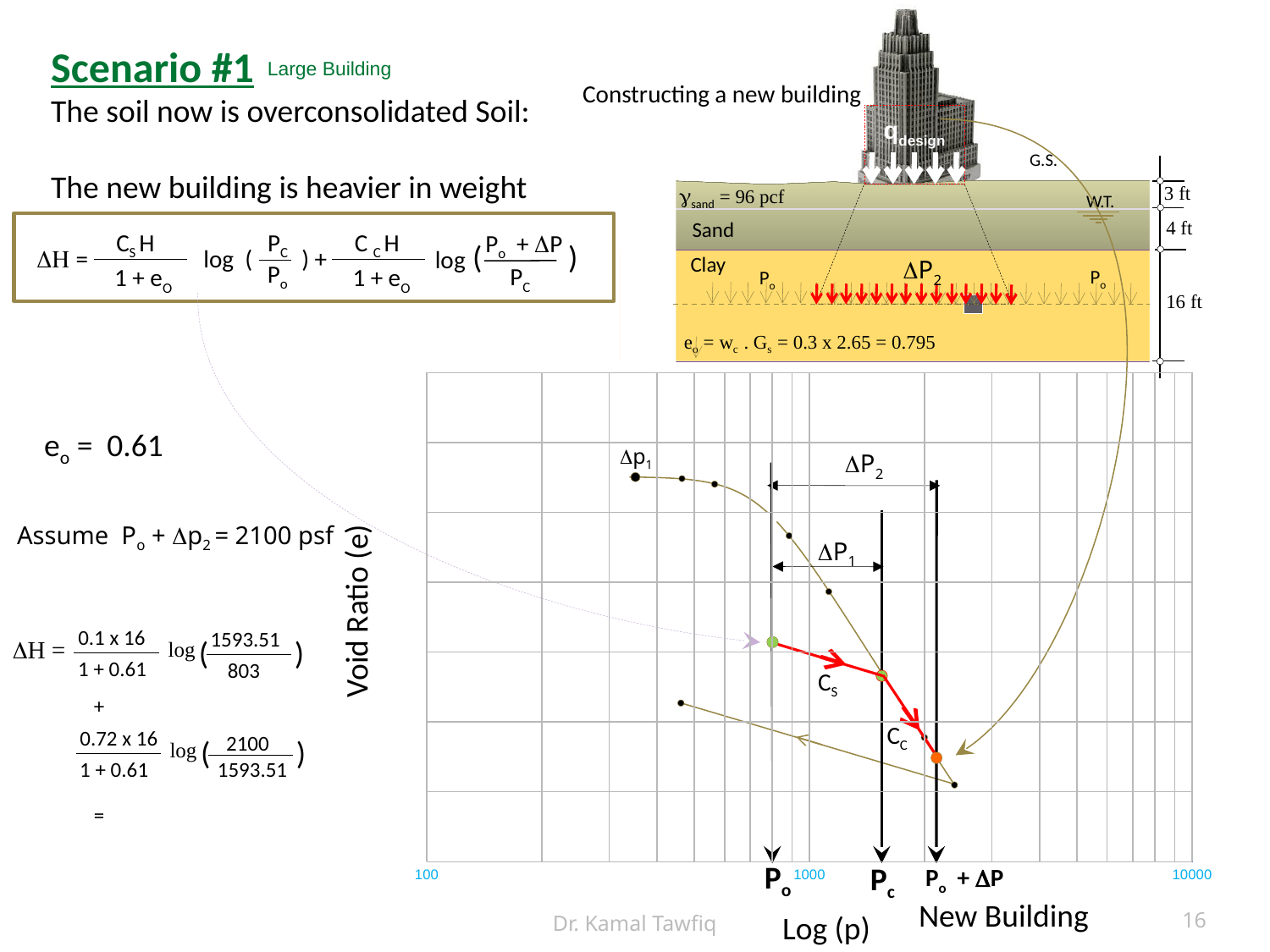
What is the label of the x axis of the chart? Log (p) How many pressure positions are marked with vertical lines and arrows on the x axis of the chart? 3 Which of the marked pressures on the x axis is the smallest: Po, Pc or Po + ΔP? Po What is the highest value printed on the x axis of the chart? 10000 Which pressure increment shown on the chart is larger, ΔP1 or ΔP2? ΔP2 Which of the marked pressures on the x axis is the largest: Po, Pc or Po + ΔP? Po + ΔP Does the void ratio rise or fall as Log (p) increases along the curve? fall Is the pressure marked Pc on the x axis greater or less than 1000? greater What is the lowest value printed on the x axis of the chart? 100 What kind of chart is shown on the slide? line chart What is the label of the y axis of the chart? Void Ratio (e) Is the pressure marked Po on the x axis greater or less than 1000? less